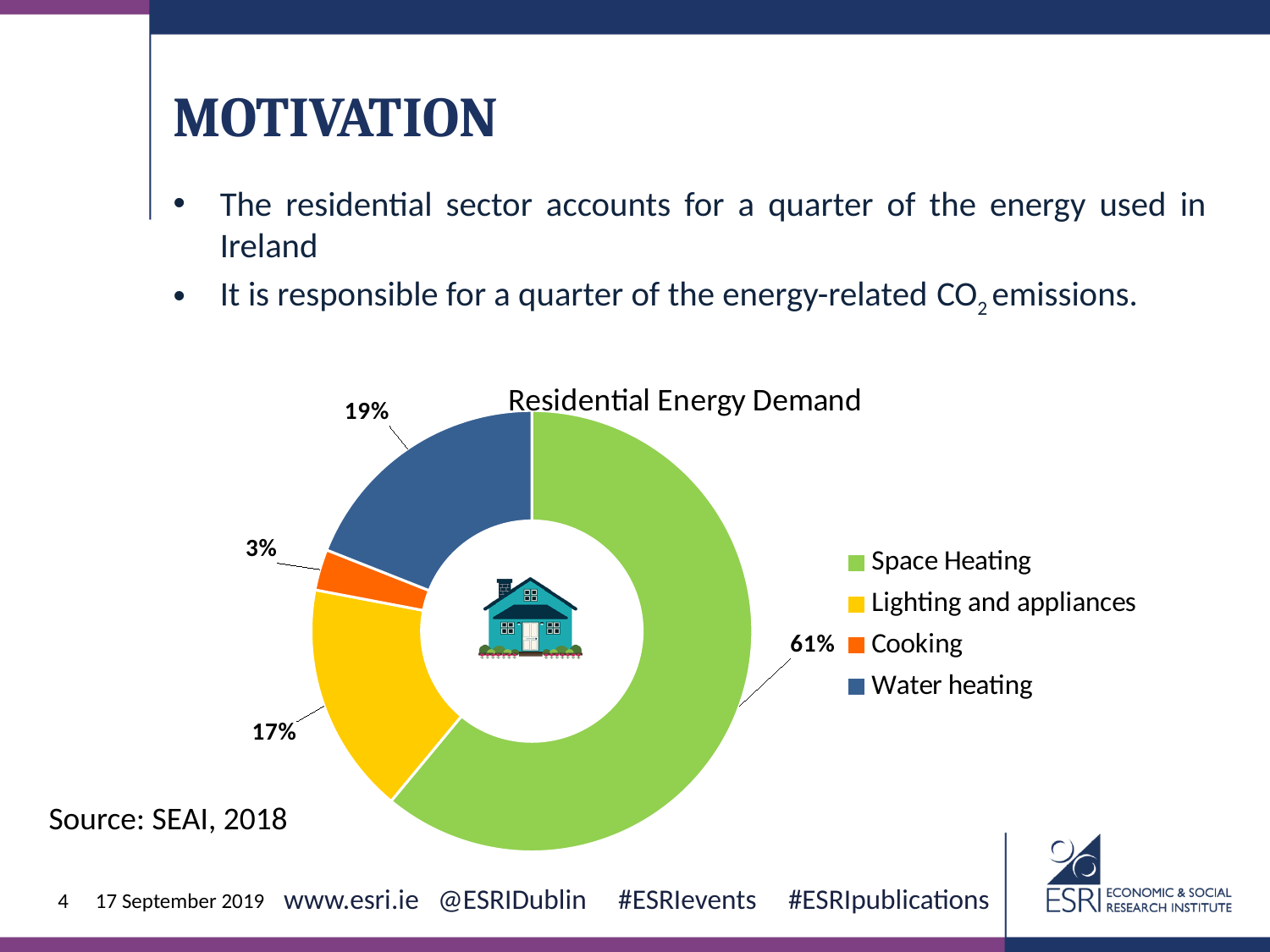
What share of residential energy demand is Cooking? 3% Which category has the smallest share of residential energy demand? Cooking What share of residential energy demand is Space Heating? 61% What share of residential energy demand is Water heating? 19% Which category has the largest share of residential energy demand? Space Heating What share of residential energy demand is Lighting and appliances? 17% What is the difference in percentage points between Space Heating and Water heating? 42 What colour represents Cooking in the chart? Orange What is the title of the chart? Residential Energy Demand Which is larger, the share for Water heating or the share for Lighting and appliances? Water heating How many categories does the chart show? 4 What kind of chart is shown on the slide? Pie chart (doughnut)